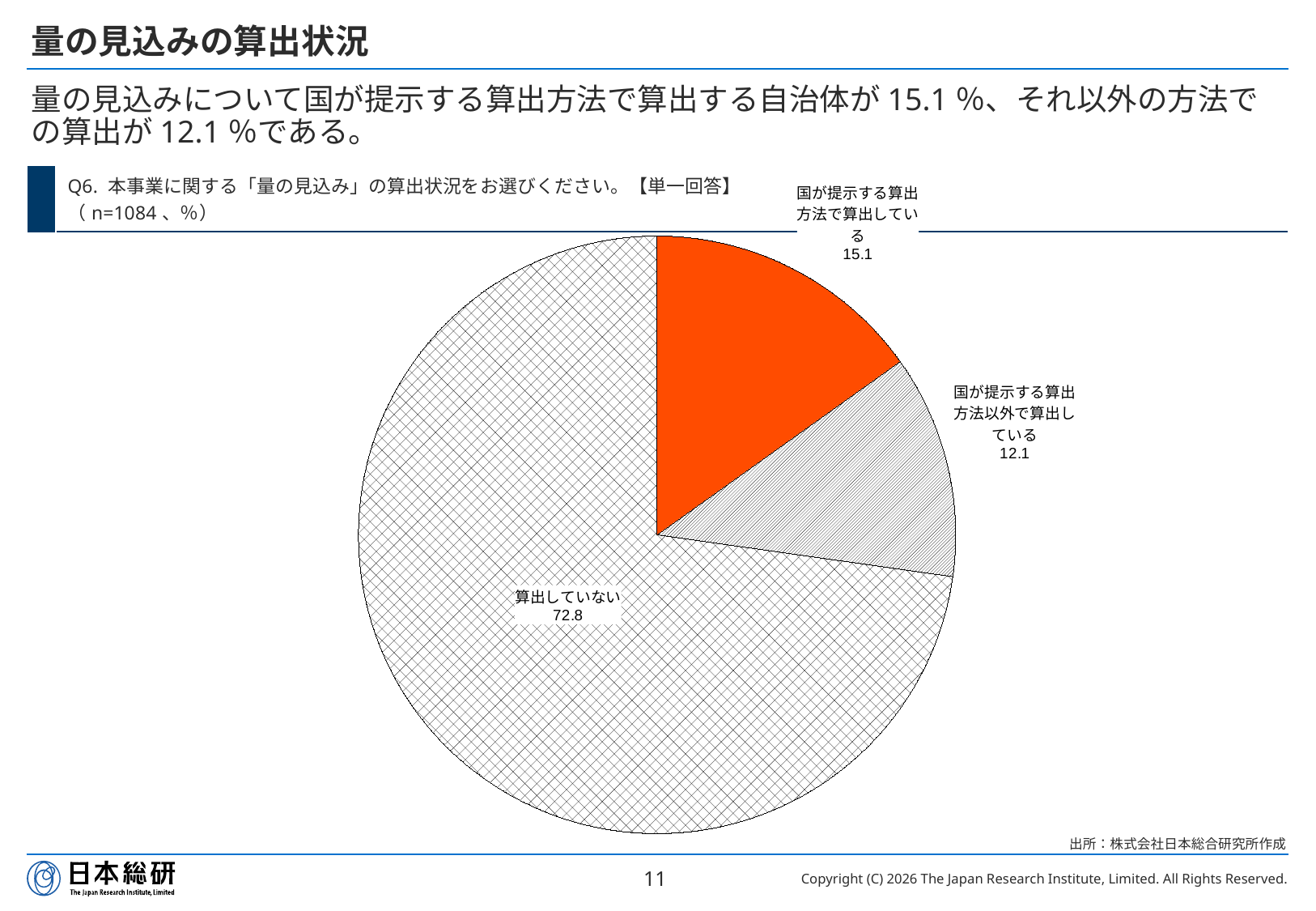
What is the sample size (n) shown for the chart? 1084 What is the difference between the values for 国が提示する算出方法で算出している and 国が提示する算出方法以外で算出している? 3.0 Which slice of the pie is coloured solid orange? 国が提示する算出方法で算出している What is the value for 算出していない? 72.8 What is the difference between the values for 算出していない and 国が提示する算出方法で算出している? 57.7 Which category has the largest share of the pie? 算出していない What kind of chart is shown on the slide? pie chart Which category has the smallest share of the pie? 国が提示する算出方法以外で算出している How many slices does the pie chart have? 3 Which is larger, the value for 国が提示する算出方法で算出している or 国が提示する算出方法以外で算出している? 国が提示する算出方法で算出している What is the value for 国が提示する算出方法で算出している? 15.1 What is the value for 国が提示する算出方法以外で算出している? 12.1